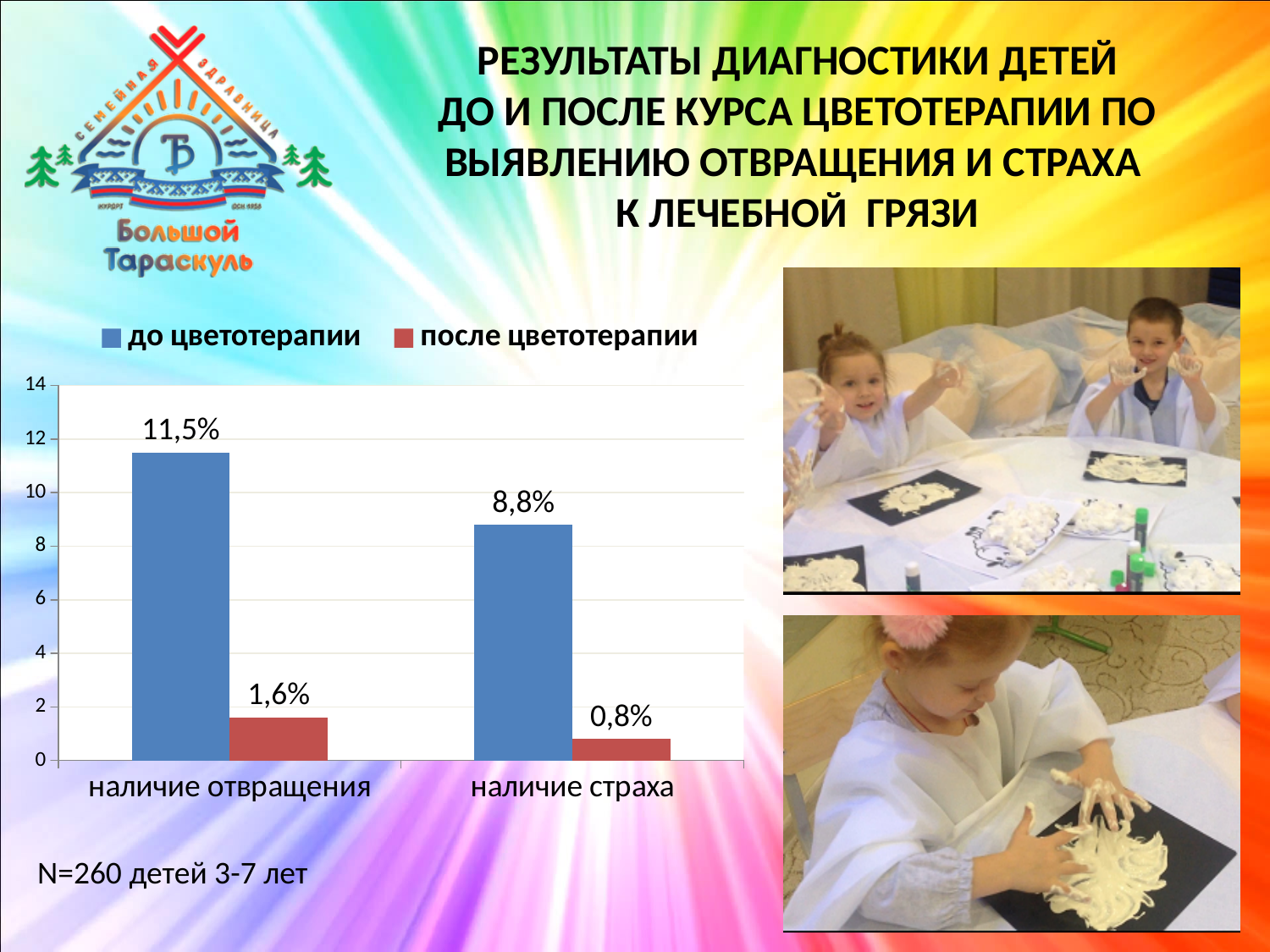
How many series does the chart legend list? 2 Which colour represents the 'после цветотерапии' series in the chart? red What is the value for 'наличие страха' before colour therapy ('до цветотерапии')? 8,8% Which category has the lowest value in the 'после цветотерапии' series? наличие страха Which category has the highest value in the 'до цветотерапии' series? наличие отвращения What is the value for 'наличие отвращения' after colour therapy ('после цветотерапии')? 1,6% What is the value for 'наличие страха' in the 'после цветотерапии' series? 0,8% How many categories are shown on the x axis of the chart? 2 Which is larger: the 'до цветотерапии' value for 'наличие страха' or the 'после цветотерапии' value for 'наличие отвращения'? до цветотерапии value for наличие страха What is the difference between the 'до цветотерапии' and 'после цветотерапии' values for 'наличие отвращения'? 9,9% What kind of chart is shown on the slide? bar chart What is the value for 'наличие отвращения' in the 'до цветотерапии' series? 11,5%